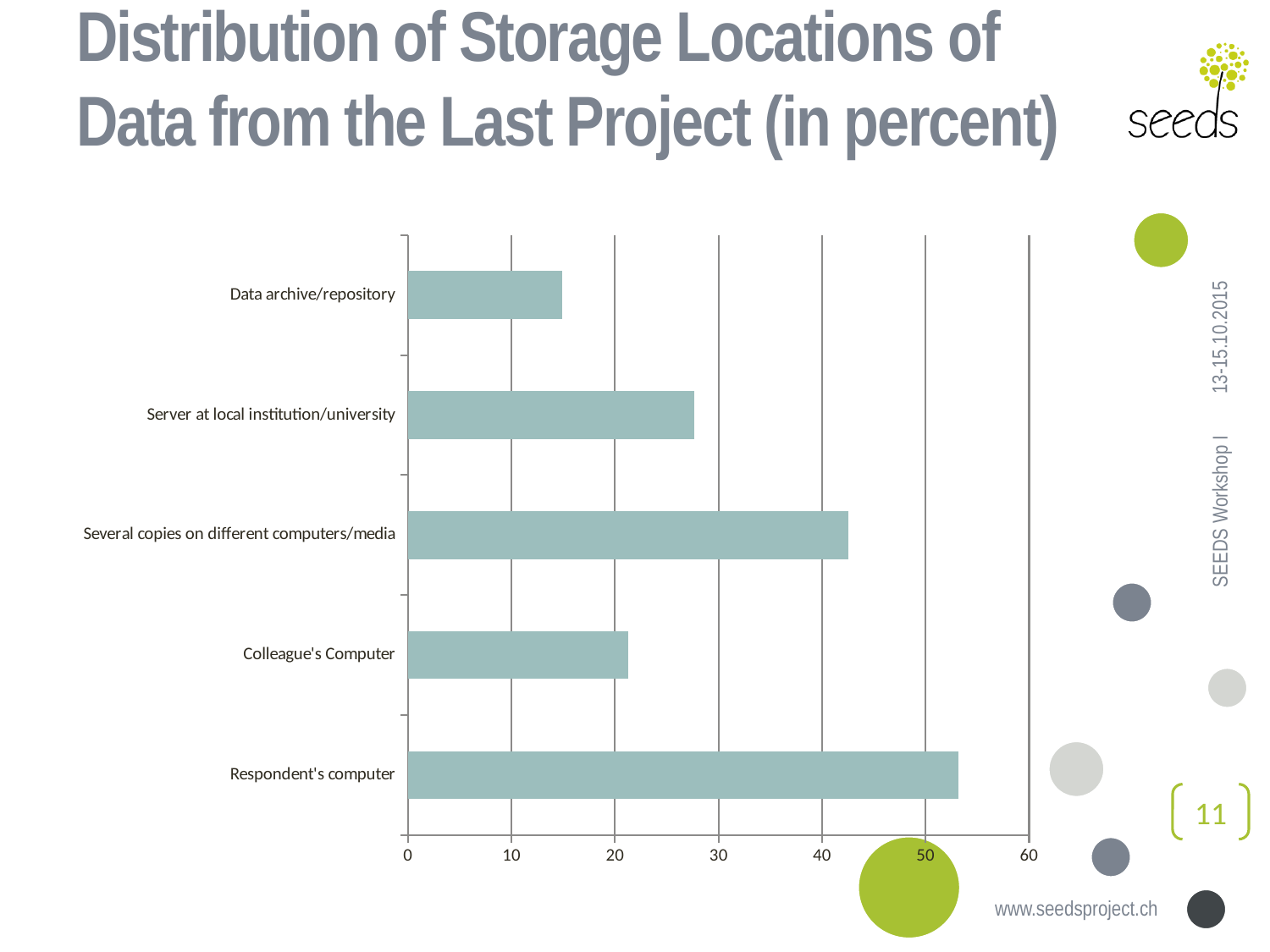
How many storage location categories are shown in the chart? 5 Which storage location has the lowest value? Data archive/repository Is the value for Several copies on different computers/media greater or less than 40? greater Is the value for Respondent's computer greater or less than 50? greater Is the value for Colleague's Computer greater or less than 30? less Which is larger: the value for Server at local institution/university or the value for Colleague's Computer? Server at local institution/university Which is larger: the value for Several copies on different computers/media or the value for Server at local institution/university? Several copies on different computers/media What kind of chart is shown on the slide? Bar chart Which storage location has the highest value? Respondent's computer What is the title of the slide containing the chart? Distribution of Storage Locations of Data from the Last Project (in percent)